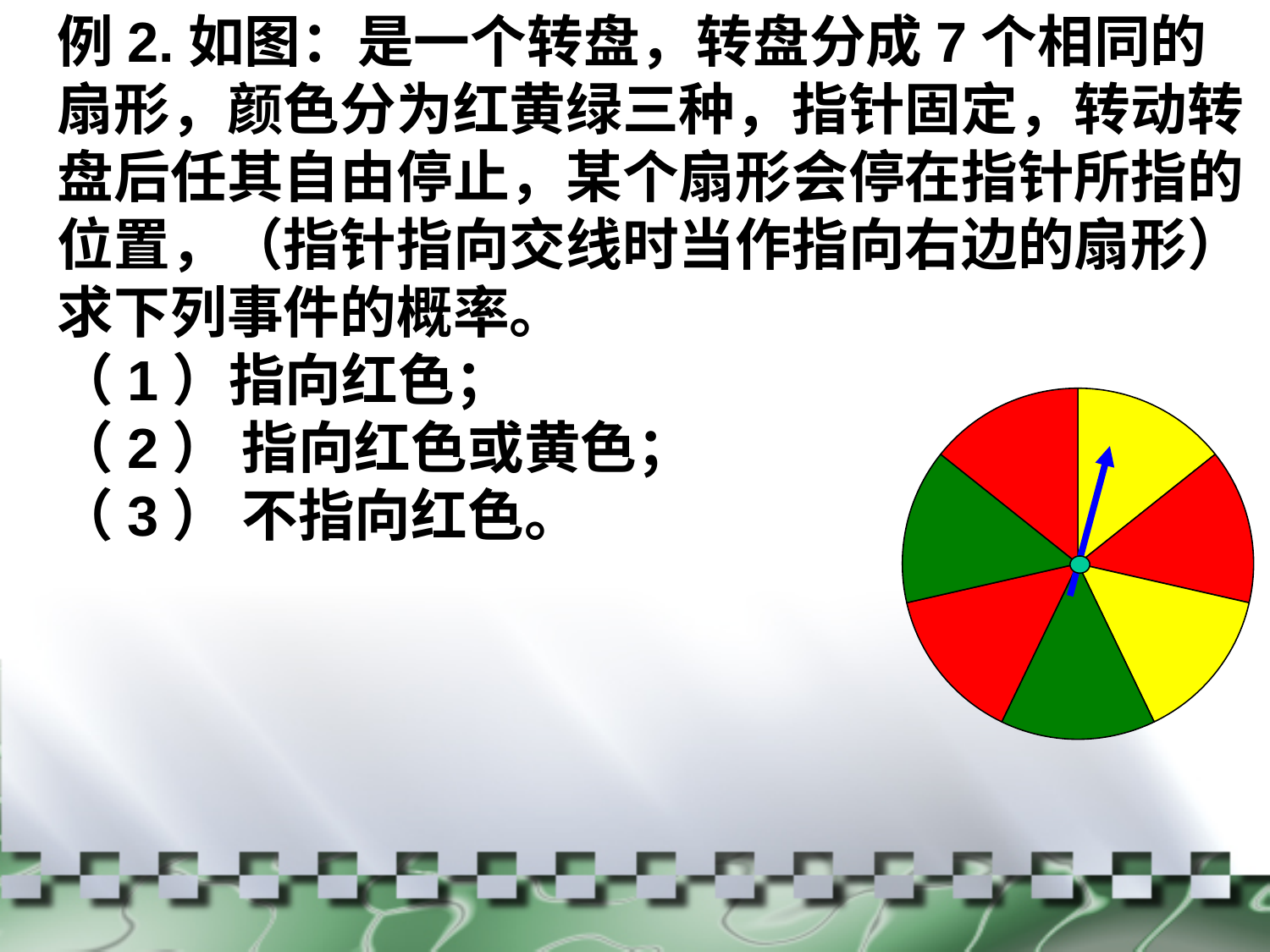
What colour is the pointer (arrow) on the spinner? blue How many green sectors does the spinner have? 2 How many sectors is the spinner on the slide divided into? 7 Are there more red sectors or more yellow sectors on the spinner? red Which colour sector is the pointer currently pointing at? yellow How many red sectors does the spinner have? 3 What shape is the spinner shown on the slide? a circle Which colour occupies the most sectors on the spinner? red